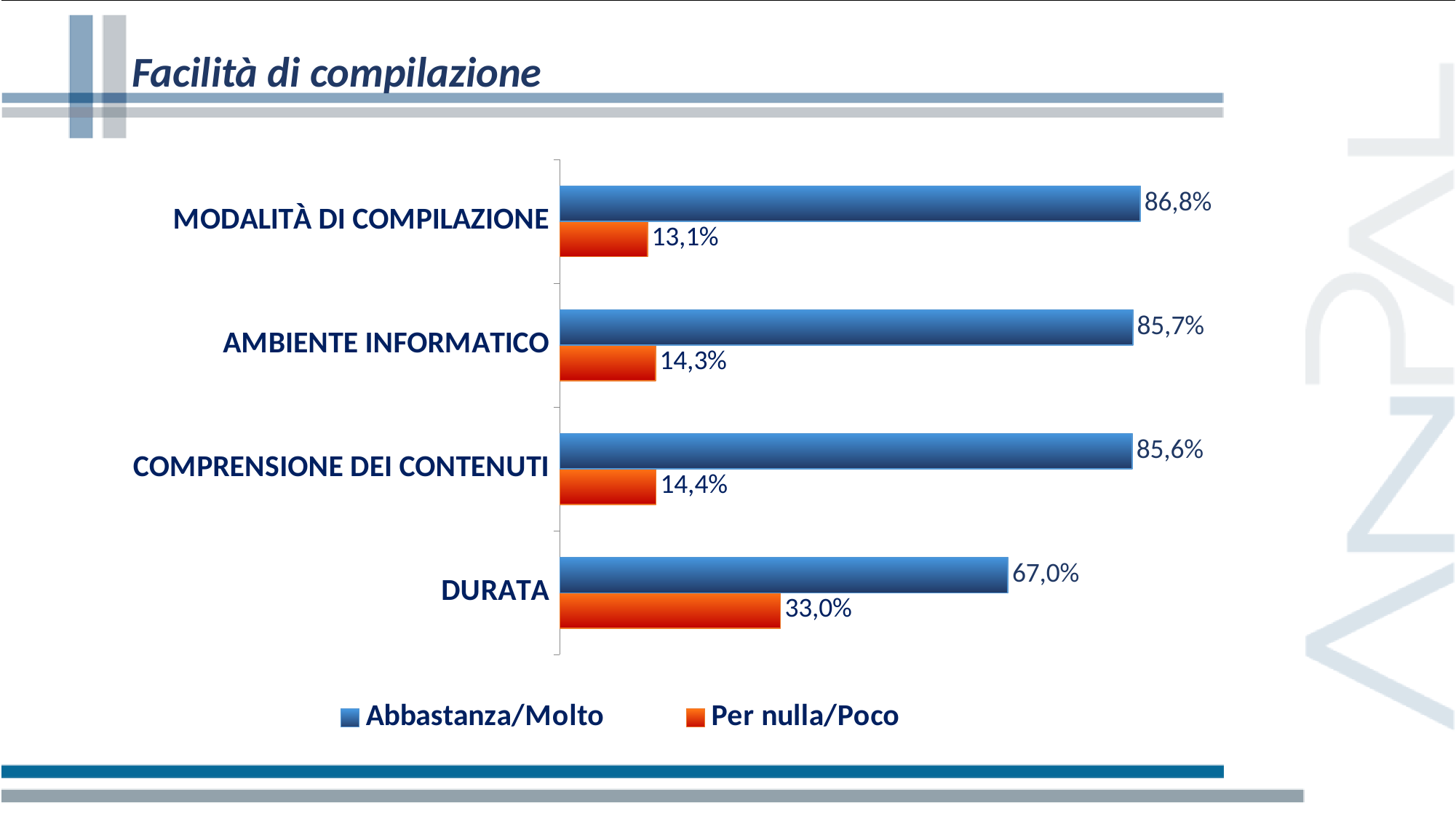
Which category has the highest Abbastanza/Molto value? MODALITÀ DI COMPILAZIONE What is the Abbastanza/Molto value for COMPRENSIONE DEI CONTENUTI? 85,6% What is the difference between the Abbastanza/Molto and Per nulla/Poco values for DURATA? 34,0% Which category has the highest Per nulla/Poco value? DURATA What is the Per nulla/Poco value for DURATA? 33,0% How many categories are shown in the chart? 4 What is the Per nulla/Poco value for AMBIENTE INFORMATICO? 14,3% What kind of chart is shown on the slide? Bar chart Which category has the lowest Abbastanza/Molto value? DURATA Which is larger: the Per nulla/Poco value for DURATA or for MODALITÀ DI COMPILAZIONE? DURATA What is the Abbastanza/Molto value for MODALITÀ DI COMPILAZIONE? 86,8% How many series does the legend list? 2